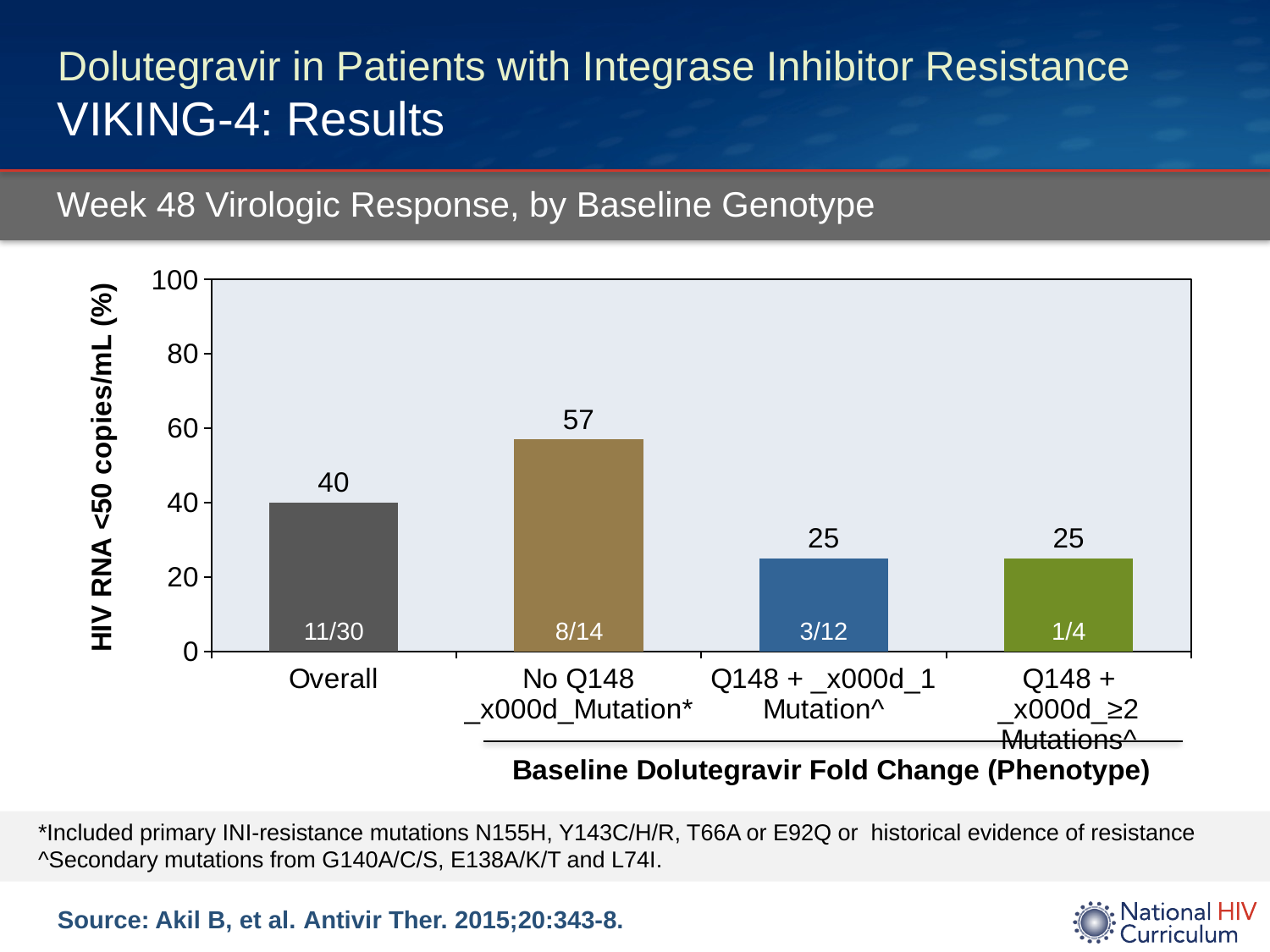
What is the difference between the Overall value and the Q148 + 1 Mutation value? 15 Which is larger, the value for Overall or the value for No Q148 Mutation? No Q148 Mutation What is the difference between the No Q148 Mutation value and the Overall value? 17 What is the label of the y axis? HIV RNA <50 copies/mL (%) What is the value for the No Q148 Mutation bar? 57 Which category has the highest value? No Q148 Mutation What is the value for the Q148 + 1 Mutation bar? 25 What kind of chart is shown on the slide? Bar chart What is the value for the Overall bar? 40 What fraction is printed inside the Overall bar? 11/30 What fraction is printed inside the Q148 + ≥2 Mutations bar? 1/4 How many categories are shown on the x axis? 4